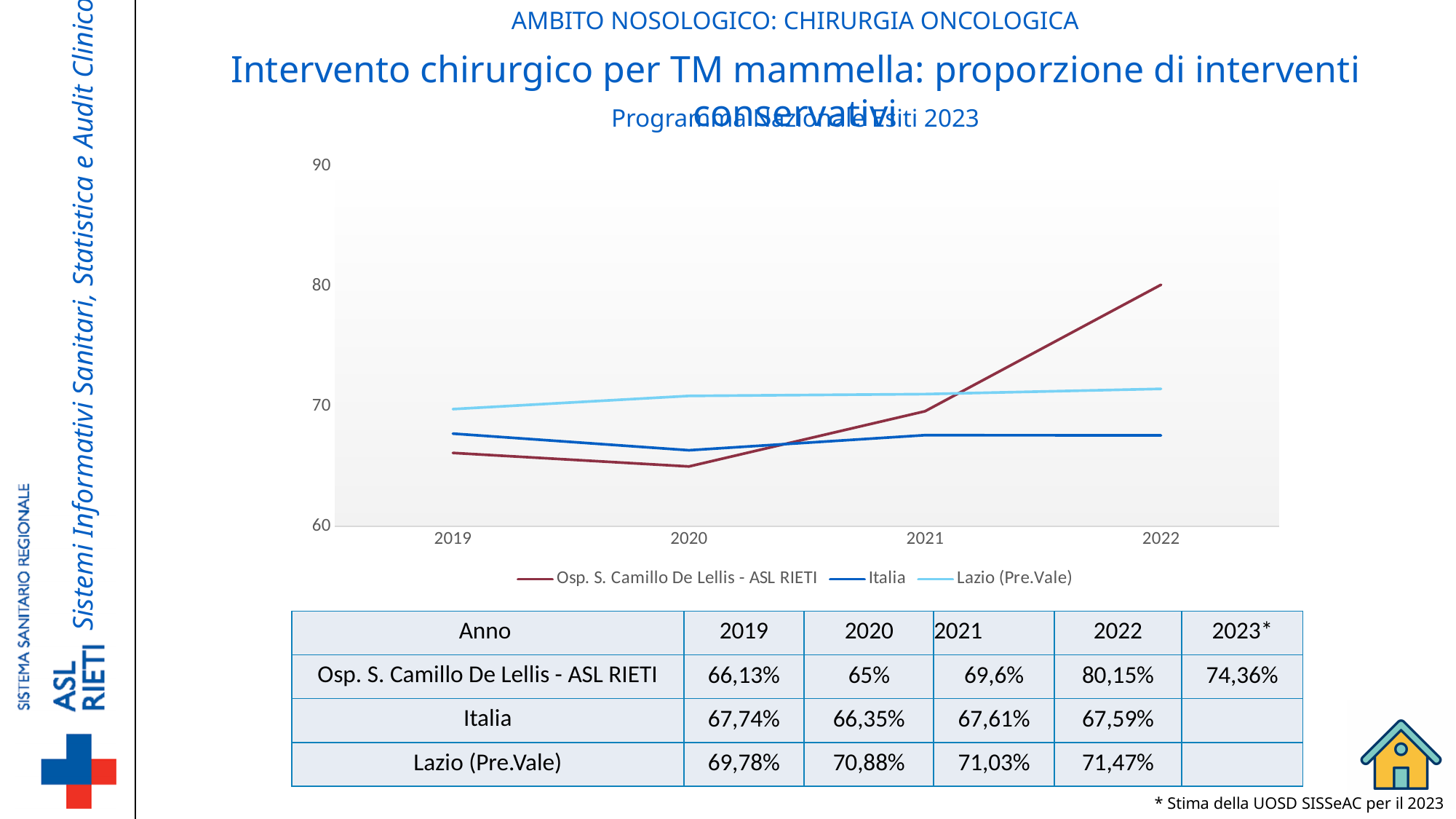
What is the value for Italia in 2020? 66,35% In which year is the value for Osp. S. Camillo De Lellis - ASL RIETI lowest? 2020 In 2019, which is larger: the value for Italia or for Osp. S. Camillo De Lellis - ASL RIETI? Italia Does the Lazio (Pre.Vale) line rise or fall from 2019 to 2022? rises What is the value for Lazio (Pre.Vale) in 2021? 71,03% Is the value for Osp. S. Camillo De Lellis - ASL RIETI in 2022 greater or less than 70? greater What is the difference between the 2022 values for Osp. S. Camillo De Lellis - ASL RIETI and Lazio (Pre.Vale)? 8,68% How many years are plotted along the x axis of the chart? 4 How many series does the chart legend list? 3 What kind of chart is shown on the slide? line chart In which year is the value for Osp. S. Camillo De Lellis - ASL RIETI highest? 2022 What is the value for Osp. S. Camillo De Lellis - ASL RIETI in 2022? 80,15%